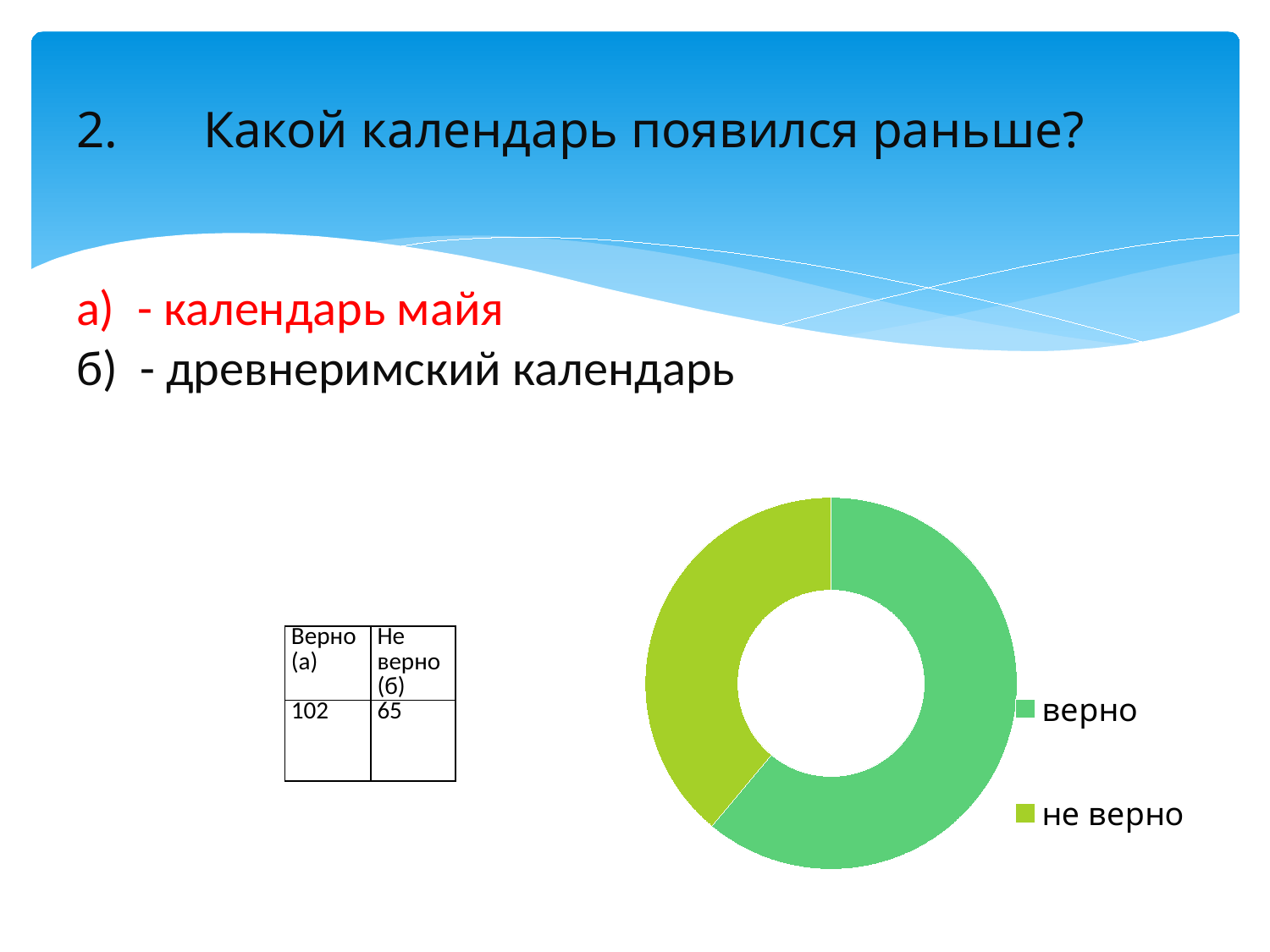
Using the values in the table next to the chart, what is the difference between 'Верно' and 'Не верно'? 37 How many slices does the doughnut chart have? 2 Which category takes the largest share of the doughnut chart? верно What are the two legend entries of the doughnut chart? верно, не верно How many entries does the legend of the doughnut chart list? 2 Which category takes the smallest share of the doughnut chart? не верно According to the table next to the chart, what is the value for 'Не верно (б)'? 65 Which slice of the doughnut chart is larger, 'верно' or 'не верно'? верно Which legend entry of the doughnut chart is shown in the lighter yellow-green colour? не верно According to the table next to the chart, what is the value for 'Верно (а)'? 102 What kind of chart is shown on the slide? doughnut chart